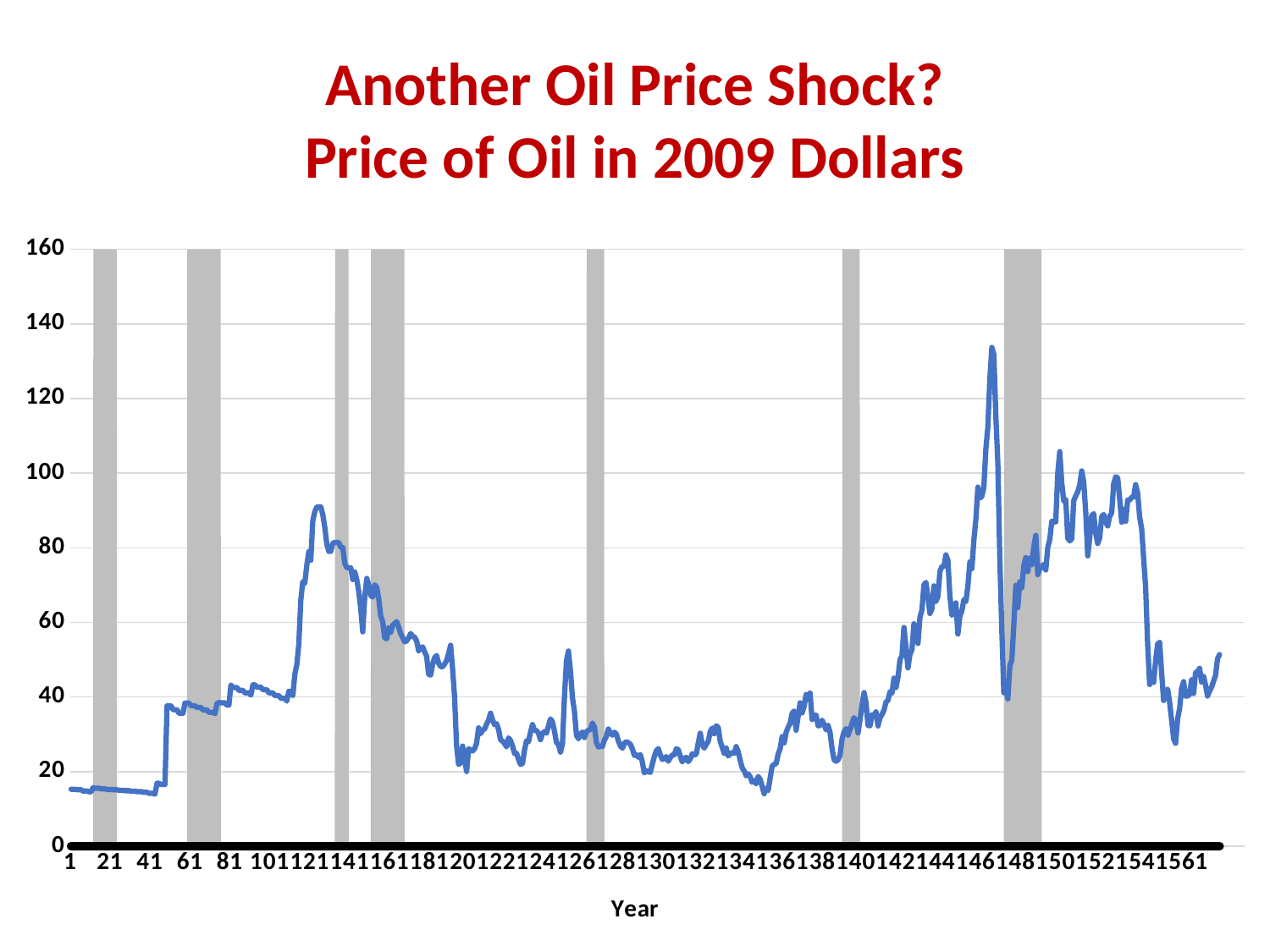
Is the value at x = 1 greater or less than 20? less Is the value at x = 341 greater or less than 20? less What kind of chart is shown on the slide? line chart Is the highest peak of the line greater or less than 120? greater Near which x-axis tick does the line reach its highest value? 461 What is the title of the chart? Another Oil Price Shock? Price of Oil in 2009 Dollars Does the line generally rise or fall between x = 381 and x = 461? rise Which is larger, the value at x = 121 or the value at x = 301? x = 121 What is the label on the x axis? Year Does the line generally rise or fall between x = 121 and x = 201? fall